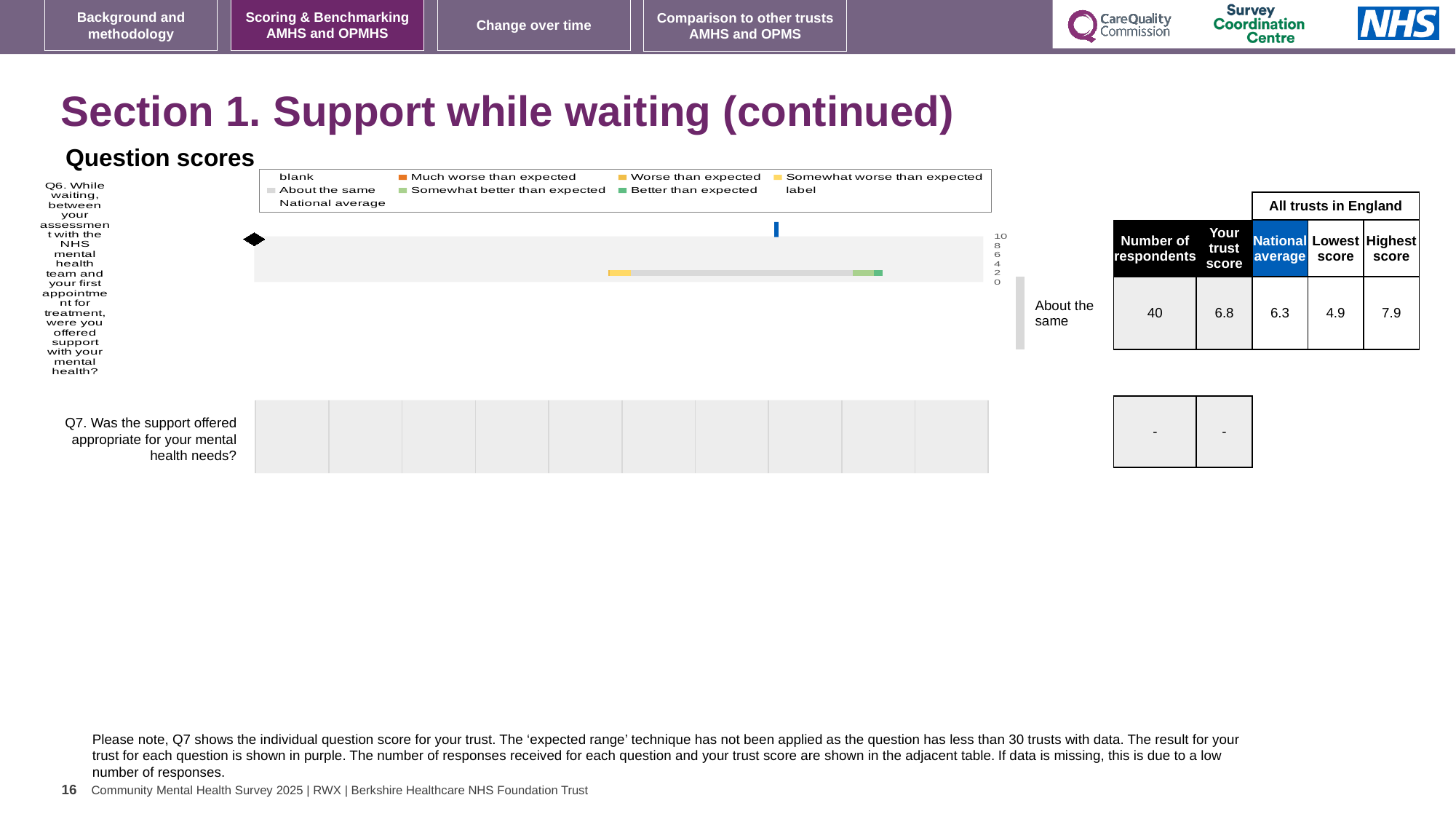
What is the lowest score among all trusts in England for Q6? 4.9 What is the highest score among all trusts in England for Q6? 7.9 By how much does the trust score for Q6 exceed the national average? 0.5 What is the maximum value shown on the chart's score axis? 10 How many questions are listed in the Question scores chart area? 2 What is the national average score for Q6? 6.3 What kind of chart is used to show the Q6 question score? bar chart What is the trust score for Q6 shown in the table next to the chart? 6.8 What is the difference between the highest and lowest scores for Q6? 3.0 Which expected-range category is the trust's Q6 result labelled as? About the same For Q6, which is larger: the trust score or the national average? the trust score How many respondents answered Q6? 40